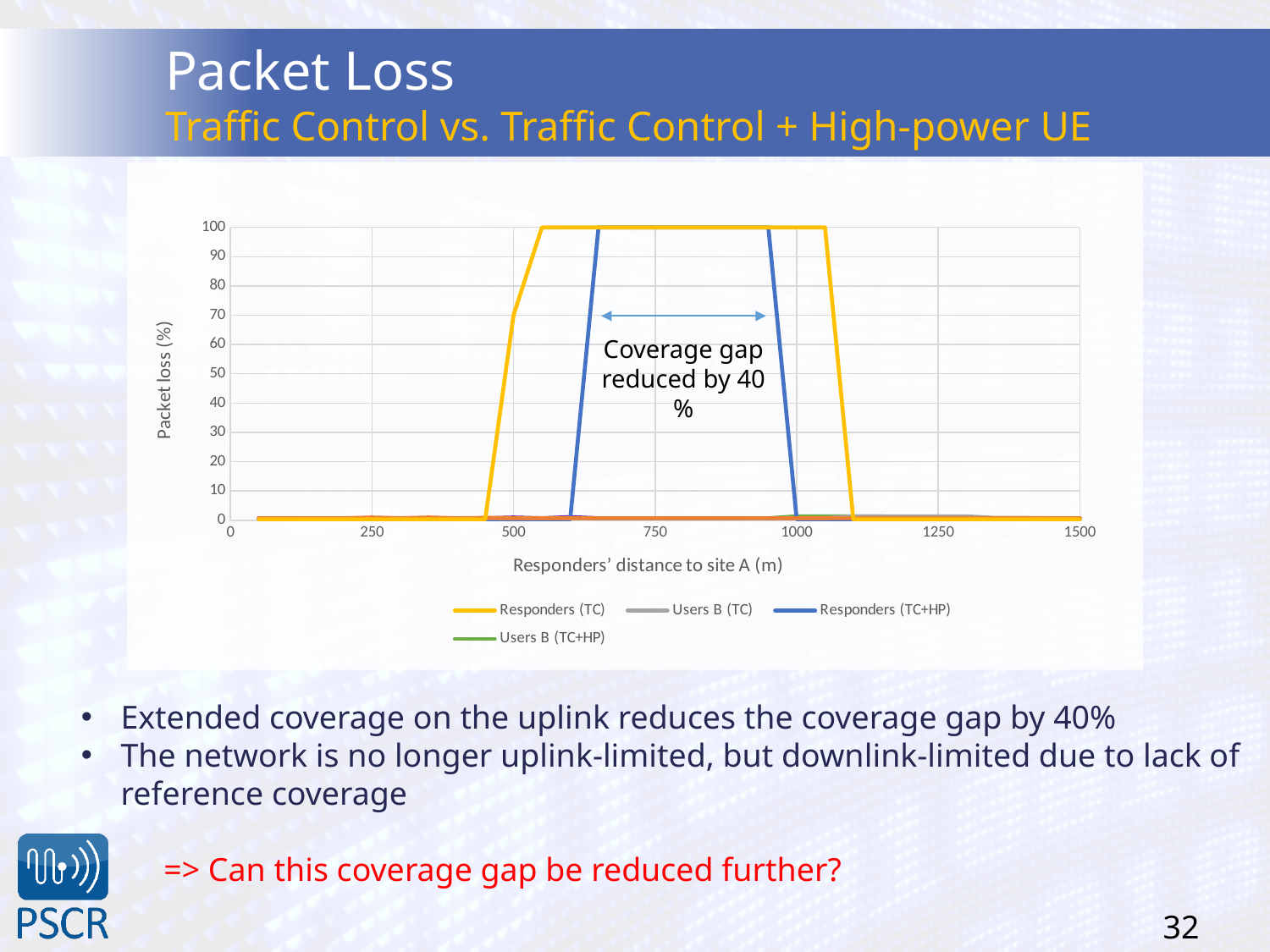
What is the packet loss for Responders (TC) at a distance of 750 m? 100 How many series does the chart legend list? 4 Which series has the wider region of 100% packet loss: Responders (TC) or Responders (TC+HP)? Responders (TC) At a distance of 600 m, which series has the higher packet loss: Responders (TC) or Responders (TC+HP)? Responders (TC) What is the title of the chart's x axis? Responders' distance to site A (m) What is the highest value shown on the chart's x axis? 1500 What kind of chart is shown on the slide? line chart Is the packet loss for Responders (TC) at 500 m greater or less than 50? greater What is the title of the chart's y axis? Packet loss (%) Is the packet loss for Responders (TC+HP) at 500 m greater or less than 10? less Is the packet loss for Responders (TC+HP) at 1000 m greater or less than 10? less